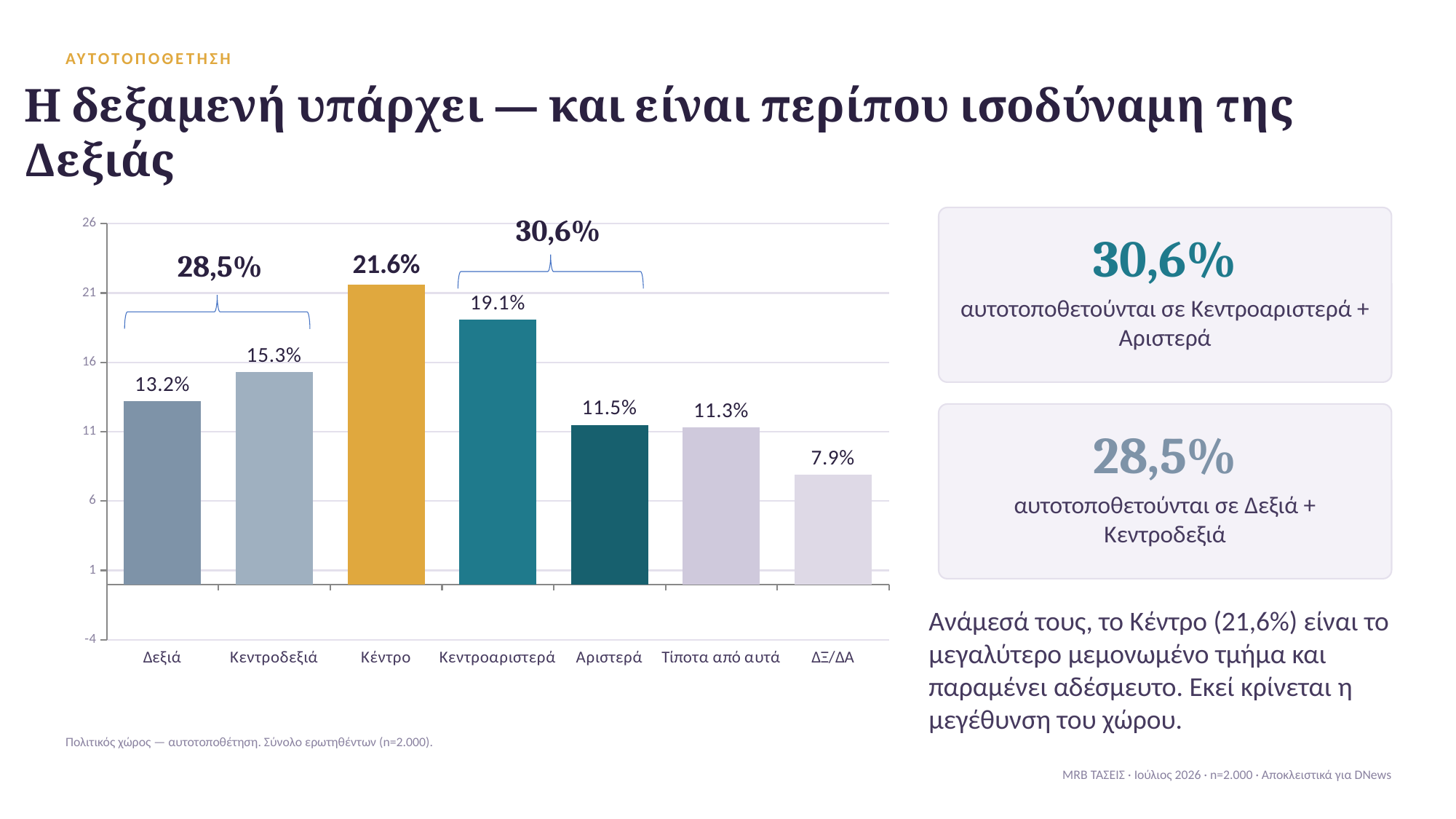
What is the value for Τίποτα από αυτά? 11.3% What is the value for Κεντροαριστερά? 19.1% Which category has the lowest value? ΔΞ/ΔΑ Is the value for Αριστερά greater or less than 11? greater How many categories are shown on the x axis? 7 What kind of chart is shown on the slide? bar chart Which category has the highest value? Κέντρο What is the value for Κέντρο? 21.6% What is the difference between the values for Κεντροδεξιά and Δεξιά? 2.1% Which is larger, the value for Κεντροαριστερά or the value for Κεντροδεξιά? Κεντροαριστερά What combined percentage does the bracket above Κεντροαριστερά and Αριστερά show? 30,6% What is the value for ΔΞ/ΔΑ? 7.9%